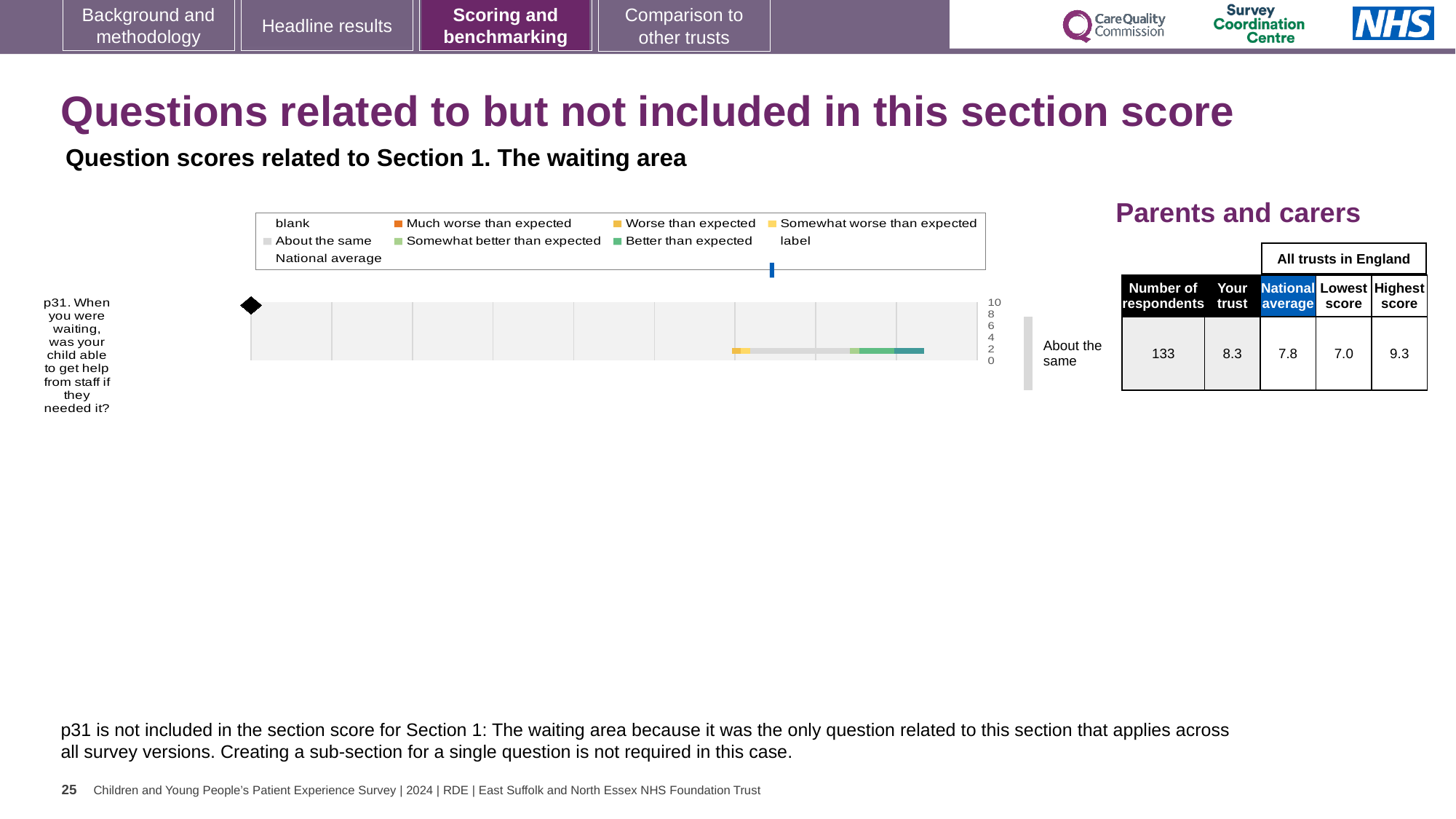
What rating label is shown to the right of the bar for p31? About the same How many questions (categories) are plotted in the chart? 1 What kind of chart is shown on the slide? bar chart In the table beside the chart, what is the Highest score across all trusts in England for p31? 9.3 Which survey question is plotted in the chart? p31. When you were waiting, was your child able to get help from staff if they needed it? What is the difference between the Highest score and the Lowest score for p31 in the table? 2.3 In the table beside the chart, how many respondents answered p31? 133 How many entries does the chart legend list? 9 Is the 'Your trust' score for p31 larger or smaller than the National average? larger In the table beside the chart, what is the National average score for p31? 7.8 In the table beside the chart, what is the 'Your trust' score for p31? 8.3 In the table beside the chart, what is the Lowest score across all trusts in England for p31? 7.0